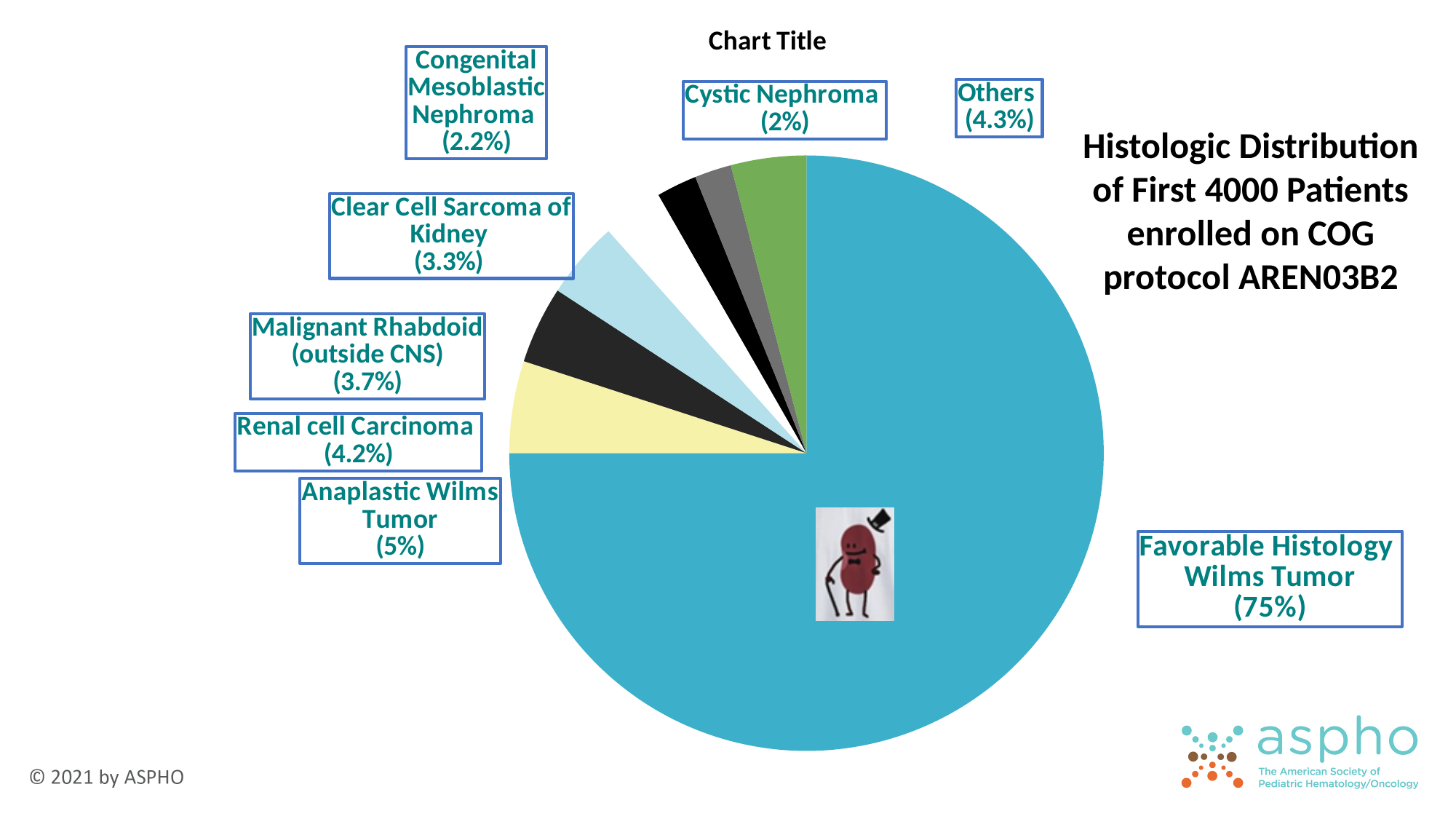
What percentage is shown for Anaplastic Wilms Tumor? 5% Which has a larger share, Renal cell Carcinoma or Malignant Rhabdoid (outside CNS)? Renal cell Carcinoma What percentage is shown for Renal cell Carcinoma? 4.2% How many categories are labelled on the pie chart? 8 Which histology category has the largest share of the pie? Favorable Histology Wilms Tumor Which labelled category has the smallest share of the pie? Cystic Nephroma What percentage is shown for Malignant Rhabdoid (outside CNS)? 3.7% What share of patients had Favorable Histology Wilms Tumor? 75% What percentage is shown for Clear Cell Sarcoma of Kidney? 3.3% What is the difference in percentage points between Favorable Histology Wilms Tumor and Anaplastic Wilms Tumor? 70 What kind of chart is shown on the slide? pie chart What percentage is shown for Congenital Mesoblastic Nephroma? 2.2%